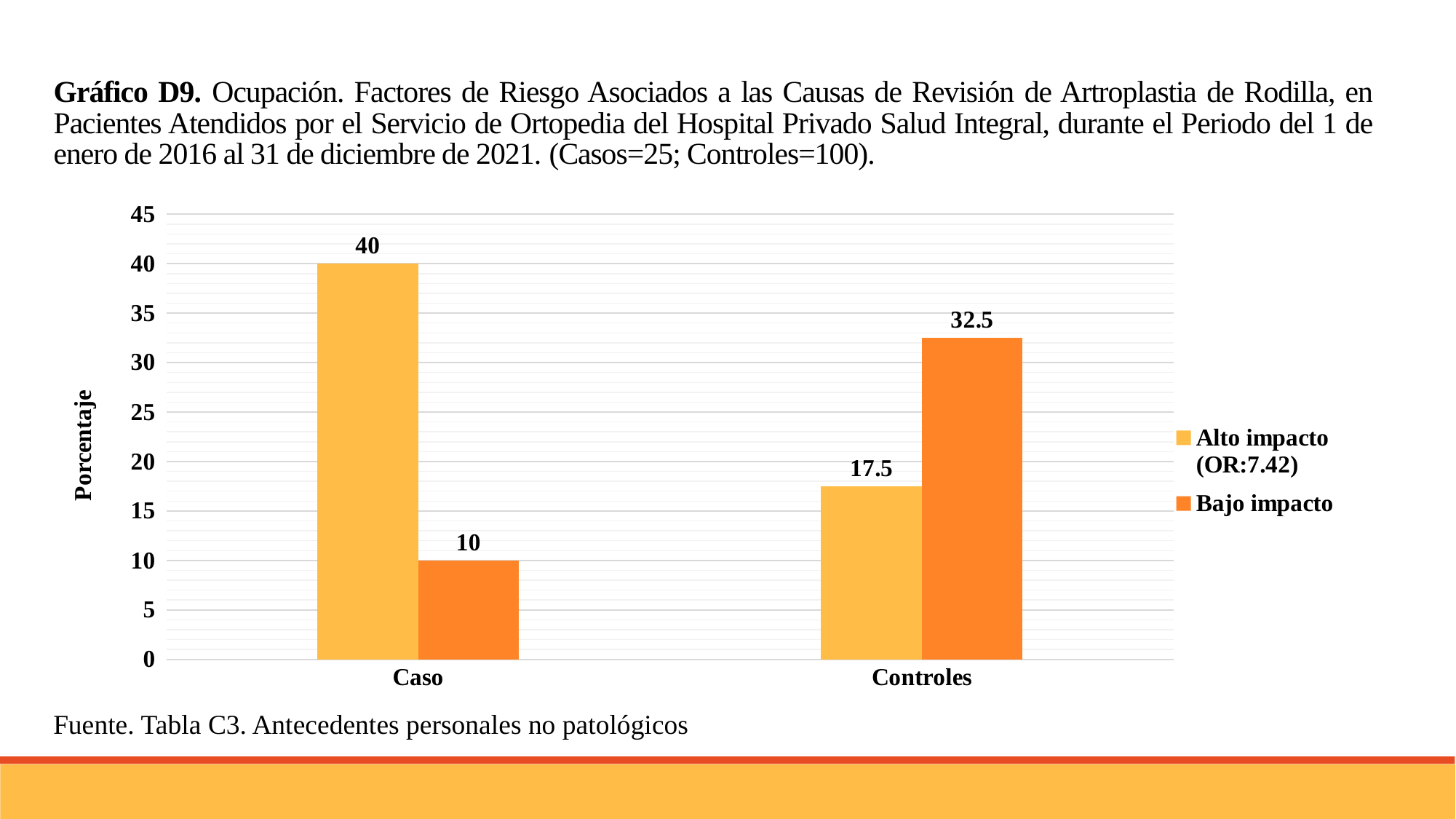
Which category has the lowest Bajo impacto value? Caso What is the value for Bajo impacto in the Caso category? 10 What is the value for Alto impacto (OR:7.42) in the Controles category? 17.5 What kind of chart is shown on the slide? Bar chart What is the value for Bajo impacto in the Controles category? 32.5 What is the difference between the Alto impacto (OR:7.42) and Bajo impacto values in the Caso category? 30 What is the value for Alto impacto (OR:7.42) in the Caso category? 40 Which category has the highest Alto impacto (OR:7.42) value? Caso How many series does the legend list? 2 What is the difference between the Bajo impacto and Alto impacto (OR:7.42) values in the Controles category? 15 Which is larger in the Controles category, Alto impacto (OR:7.42) or Bajo impacto? Bajo impacto How many categories are shown on the x axis? 2